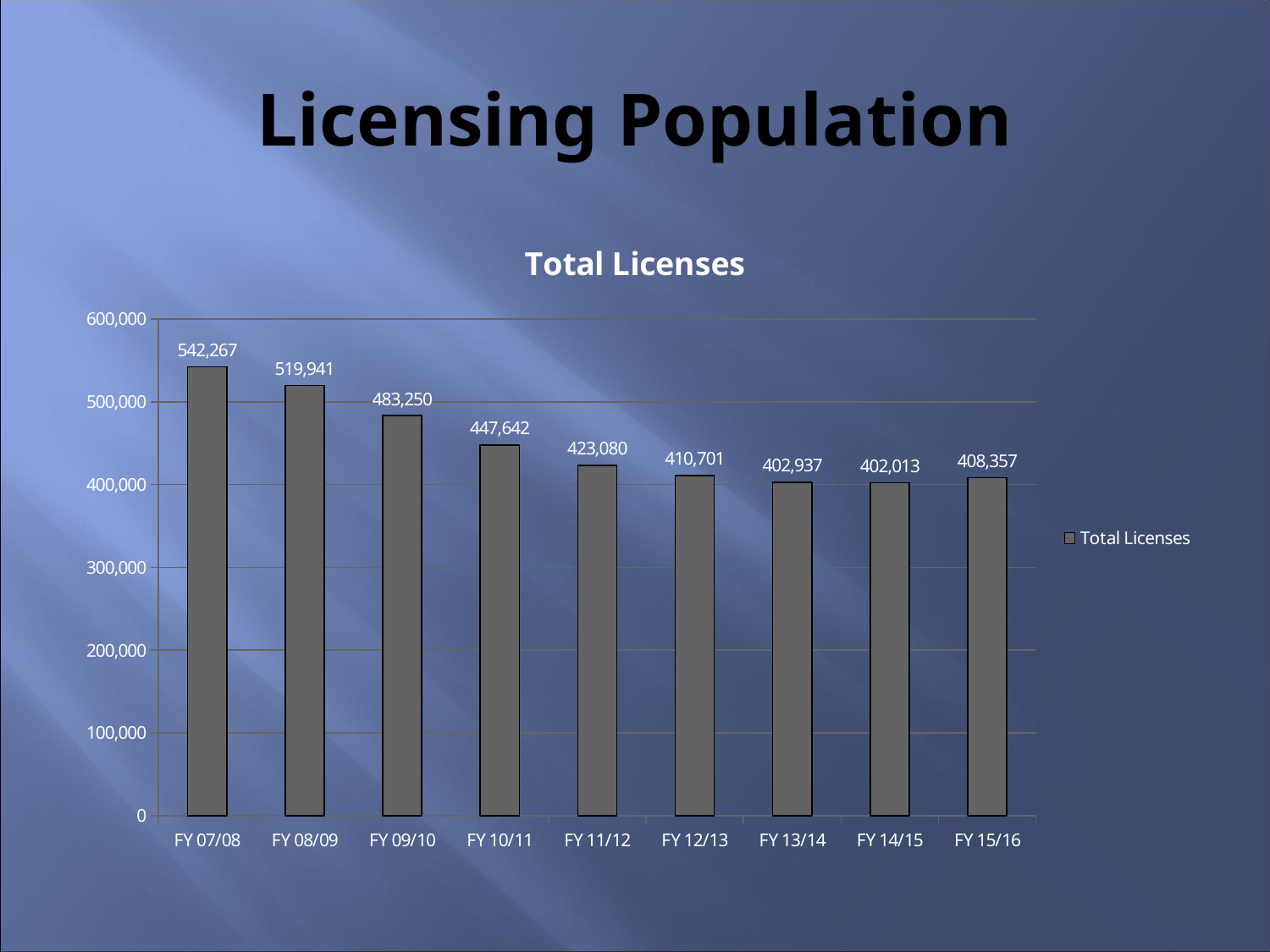
How many fiscal years are shown on the x axis? 9 Is the value for FY 09/10 greater or less than 500,000? less What is the value for FY 11/12? 423,080 What is the difference between the values for FY 07/08 and FY 08/09? 22,326 Which fiscal year has the lowest number of total licenses? FY 14/15 Do the values generally rise or fall from FY 07/08 to FY 14/15? fall What is the value for FY 15/16? 408,357 What is the difference between the values for FY 09/10 and FY 10/11? 35,608 Which fiscal year has the highest number of total licenses? FY 07/08 What is the value for FY 07/08? 542,267 Which is larger, the value for FY 12/13 or the value for FY 15/16? FY 12/13 What kind of chart is shown on the slide? bar chart